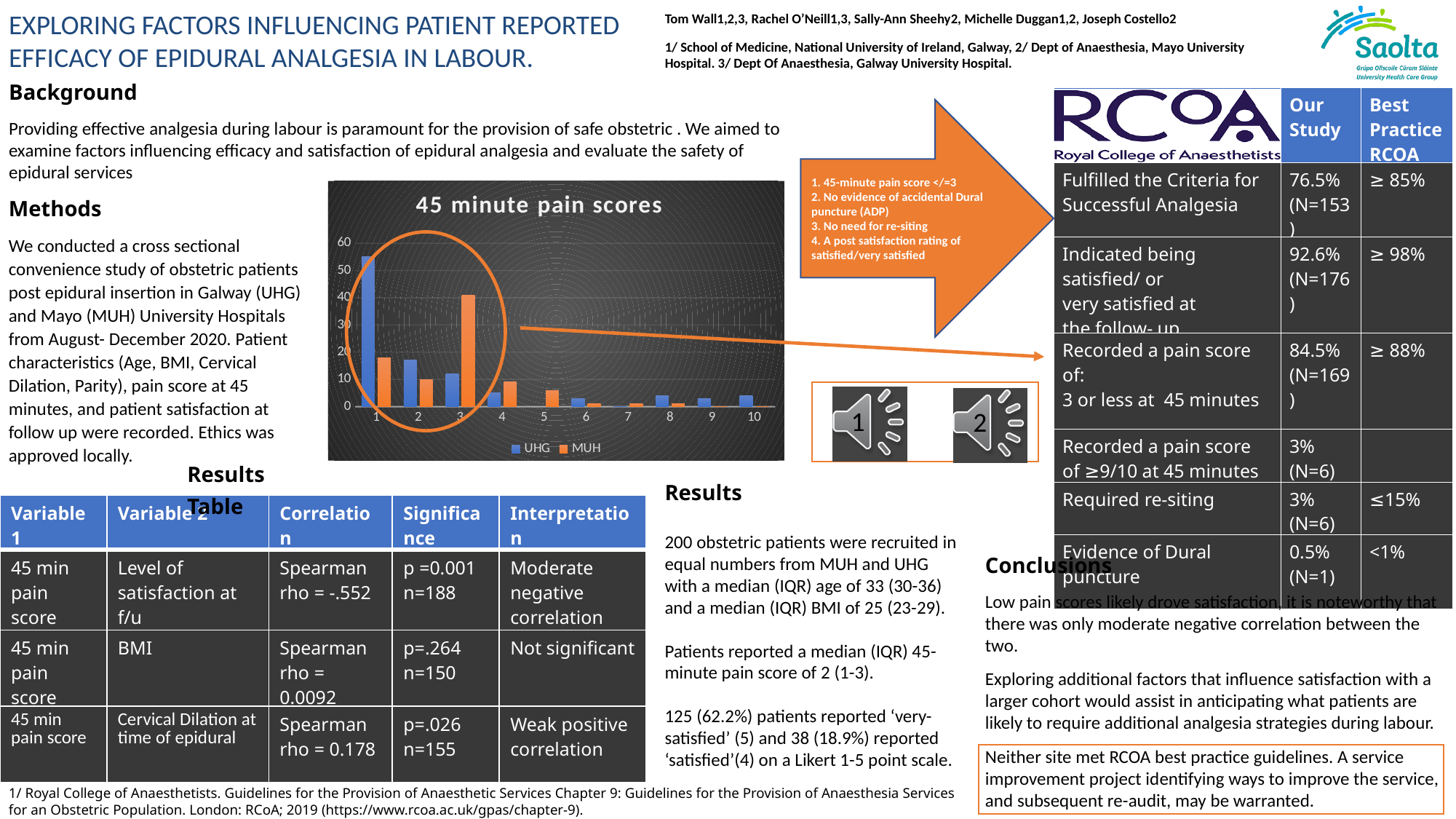
How many pain score categories are shown along the x axis of the chart? 10 Is the UHG value for pain score 2 greater or less than 20? less At pain score 3, which series has the larger value, UHG or MUH? MUH What kind of chart is shown on the slide? bar chart Is the MUH value for pain score 3 greater or less than 30? greater Which colour represents the MUH series in the chart? orange At pain score 1, which series has the larger value, UHG or MUH? UHG Which pain score has the highest UHG bar? 1 Is the UHG value for pain score 1 greater or less than 50? greater Which pain score has the highest MUH bar? 3 How many series does the legend of the '45 minute pain scores' chart list? 2 What is the title of the chart? 45 minute pain scores